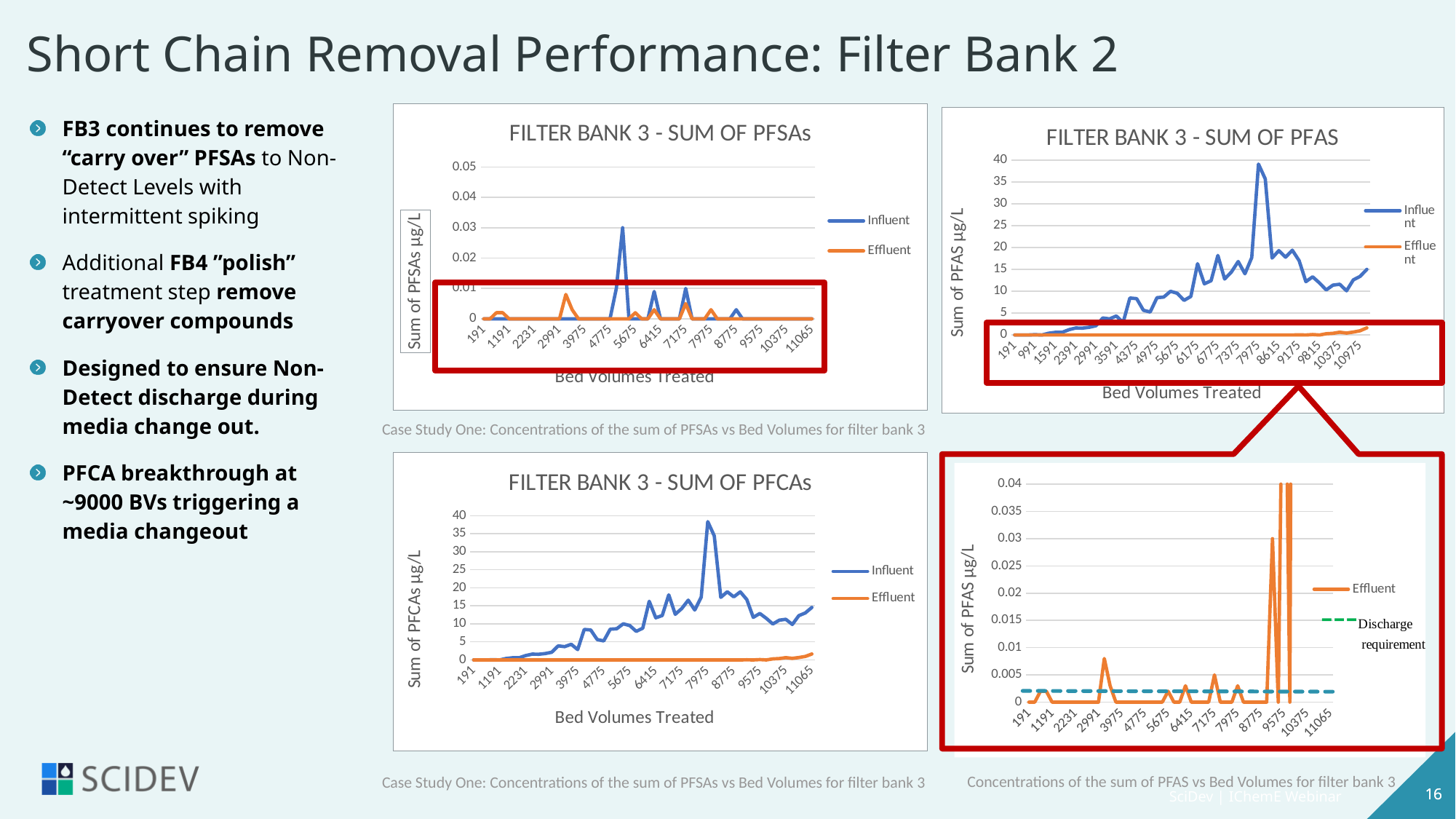
In the untitled chart at the bottom right, is the highest Effluent value greater or less than 0.035? greater How many series does the legend of the untitled chart at the bottom right list? 2 What is the x-axis title of the "FILTER BANK 3 - SUM OF PFCAs" chart? Bed Volumes Treated In the "FILTER BANK 3 - SUM OF PFCAs" chart, does the Influent line generally rise or fall between 191 and 7975 bed volumes? rise In the "FILTER BANK 3 - SUM OF PFSAs" chart, is the peak Influent value greater or less than 0.02? greater In the "FILTER BANK 3 - SUM OF PFCAs" chart, is the peak Influent value greater or less than 35? greater What is the y-axis title of the "FILTER BANK 3 - SUM OF PFAS" chart? Sum of PFAS µg/L What kind of chart is the "FILTER BANK 3 - SUM OF PFSAs" chart at the top left? line chart In the "FILTER BANK 3 - SUM OF PFAS" chart, which series reaches the highest value, Influent or Effluent? Influent How many series does the legend of the "FILTER BANK 3 - SUM OF PFSAs" chart list? 2